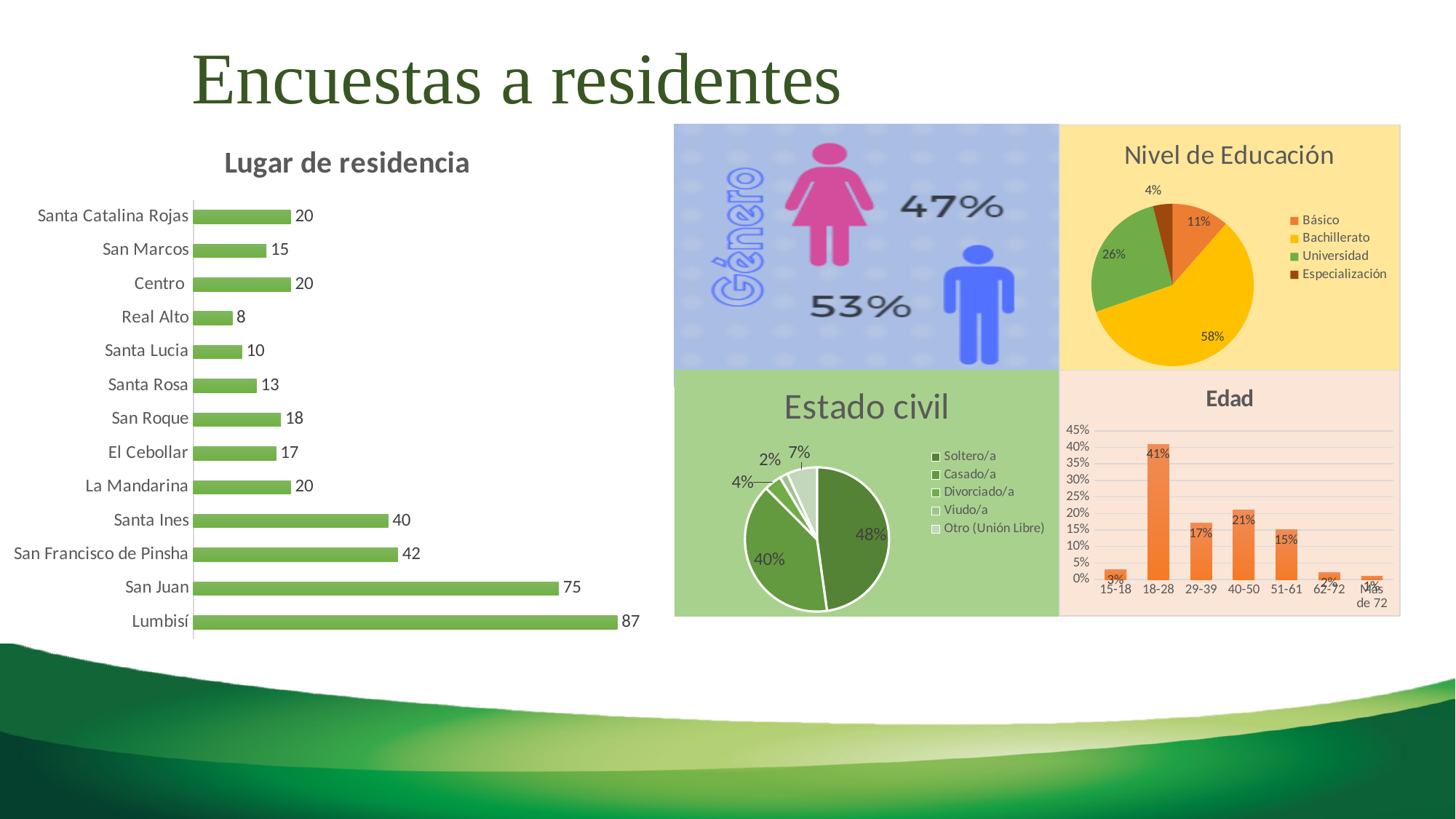
In the 'Lugar de residencia' chart, how many places are listed? 13 In the 'Lugar de residencia' chart, which place has the lowest value? Real Alto In the 'Lugar de residencia' chart, which place has the highest value? Lumbisí In the 'Nivel de Educación' pie chart, which category has the smallest share? Especialización What kind of chart is the 'Edad' chart? Bar chart In the 'Nivel de Educación' pie chart, what share does Bachillerato have? 58% In the 'Estado civil' pie chart, how many categories does the legend list? 5 In the 'Edad' chart, what is the value for the 18-28 age group? 41% In the 'Lugar de residencia' chart, what is the value for San Juan? 75 In the 'Lugar de residencia' chart, what is the difference between Lumbisí and San Juan? 12 In the 'Lugar de residencia' chart, which is larger, Santa Ines or San Francisco de Pinsha? San Francisco de Pinsha In the 'Estado civil' pie chart, what share does Casado/a have? 40%